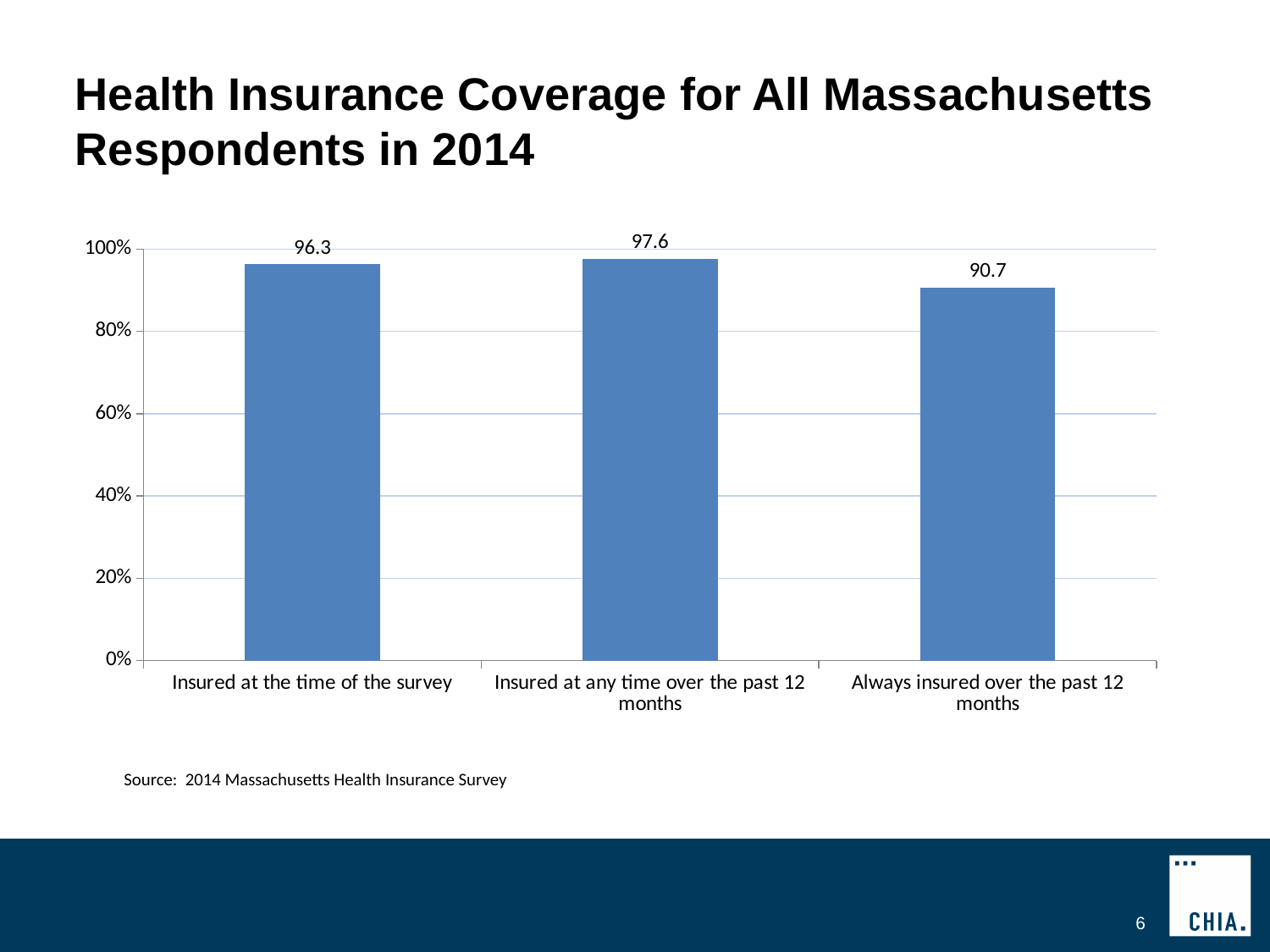
What kind of chart is shown on the slide? Bar chart Which is larger: the value for "Insured at the time of the survey" or "Always insured over the past 12 months"? Insured at the time of the survey What is the value for "Insured at any time over the past 12 months"? 97.6 What is the difference between the values for "Insured at the time of the survey" and "Always insured over the past 12 months"? 5.6 Which category has the highest value? Insured at any time over the past 12 months What is the value for "Always insured over the past 12 months"? 90.7 How many categories are shown in the chart? 3 What is the value for "Insured at the time of the survey"? 96.3 What is the source cited below the chart? 2014 Massachusetts Health Insurance Survey Is the value for "Always insured over the past 12 months" greater or less than 80%? greater Which category has the lowest value? Always insured over the past 12 months What is the difference between the values for "Insured at any time over the past 12 months" and "Always insured over the past 12 months"? 6.9